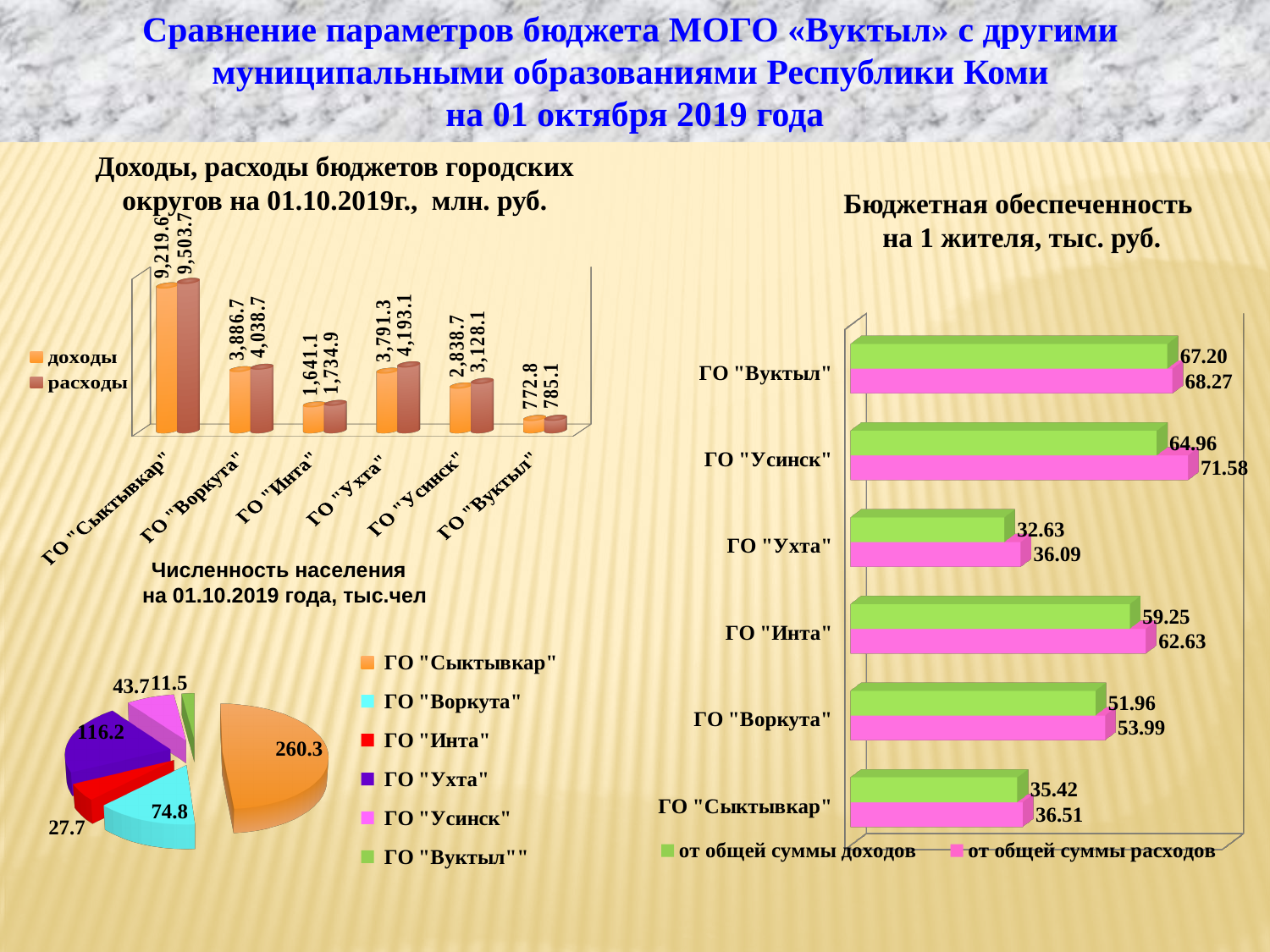
In the chart 'Бюджетная обеспеченность на 1 жителя, тыс. руб.', which is larger for ГО "Инта": 'от общей суммы доходов' or 'от общей суммы расходов'? от общей суммы расходов In the chart 'Бюджетная обеспеченность на 1 жителя, тыс. руб.', which city district has the lowest value 'от общей суммы доходов'? ГО "Ухта" In the chart 'Доходы, расходы бюджетов городских округов на 01.10.2019г., млн. руб.', what is the difference between расходы and доходы for ГО "Вуктыл"? 12.3 In the chart 'Бюджетная обеспеченность на 1 жителя, тыс. руб.', what is the value 'от общей суммы расходов' for ГО "Усинск"? 71.58 In the chart 'Доходы, расходы бюджетов городских округов на 01.10.2019г., млн. руб.', what is the value of доходы for ГО "Вуктыл"? 772.8 In the pie chart 'Численность населения на 01.10.2019 года, тыс.чел', what is the value for ГО "Ухта"? 116.2 In the pie chart 'Численность населения на 01.10.2019 года, тыс.чел', how many slices are there? 6 In the chart 'Доходы, расходы бюджетов городских округов на 01.10.2019г., млн. руб.', which city district has the highest доходы? ГО "Сыктывкар" In the chart 'Доходы, расходы бюджетов городских округов на 01.10.2019г., млн. руб.', how many series does the legend list? 2 In the chart 'Доходы, расходы бюджетов городских округов на 01.10.2019г., млн. руб.', what is the value of расходы for ГО "Ухта"? 4,193.1 In the pie chart 'Численность населения на 01.10.2019 года, тыс.чел', which city district has the smallest population? ГО "Вуктыл" What kind of chart is 'Бюджетная обеспеченность на 1 жителя, тыс. руб.'? Bar chart